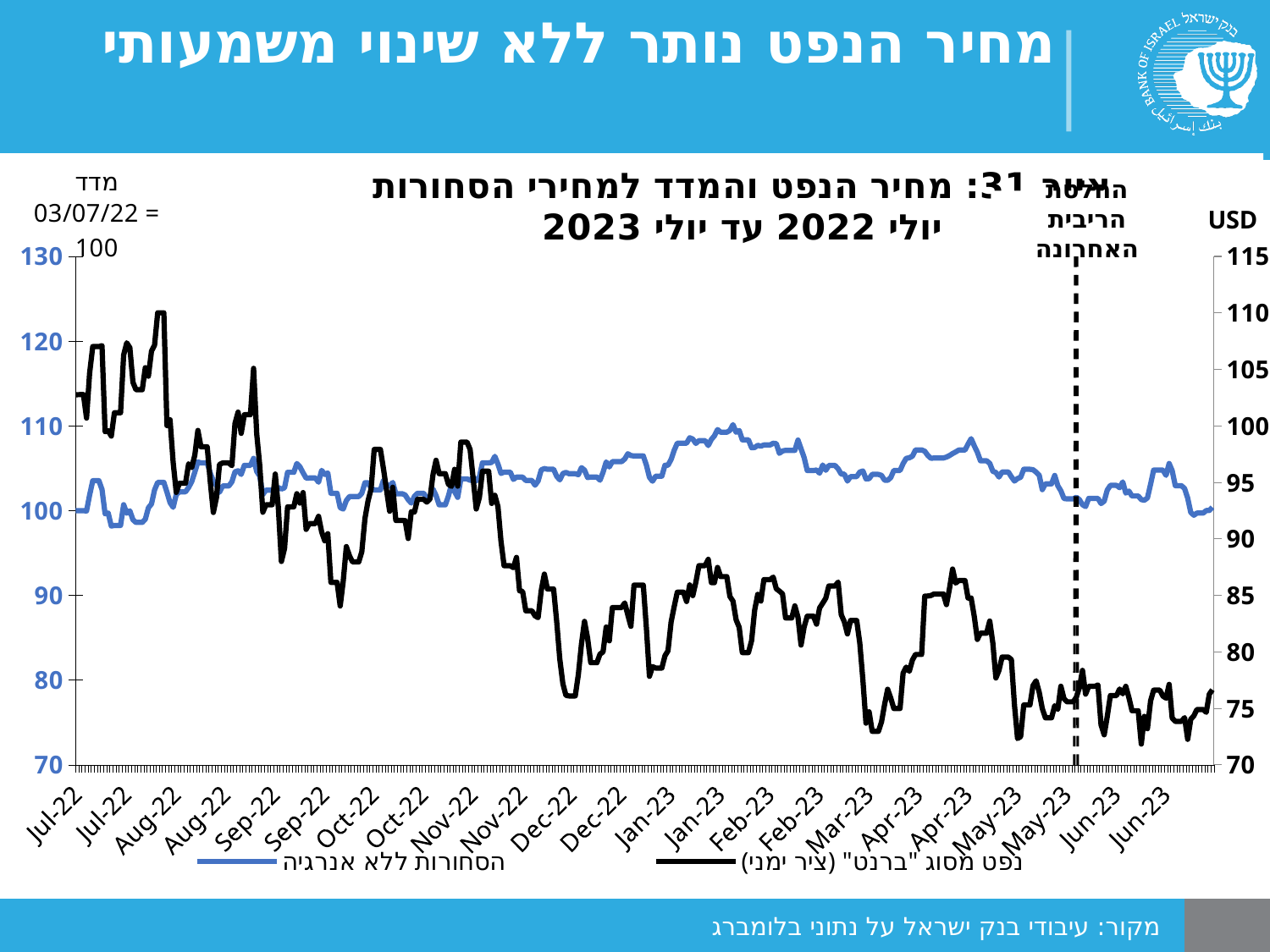
What unit is shown at the top of the right axis? USD Does the Brent oil price (black line) generally rise or fall from Jul-22 to Jun-23? fall What kind of chart is shown on the slide? line chart Which series is plotted on the right axis according to the legend? נפט מסוג "ברנט" What is the highest value shown on the left axis? 130 How many series does the legend list? 2 Is the non-energy commodities index (blue line) in Apr-23 greater or less than 100? greater Is the Brent oil price at the start of the series (Jul-22) greater or less than 100 USD? greater Is the Brent oil price at the end of the series (Jun-23) greater or less than 80 USD? less